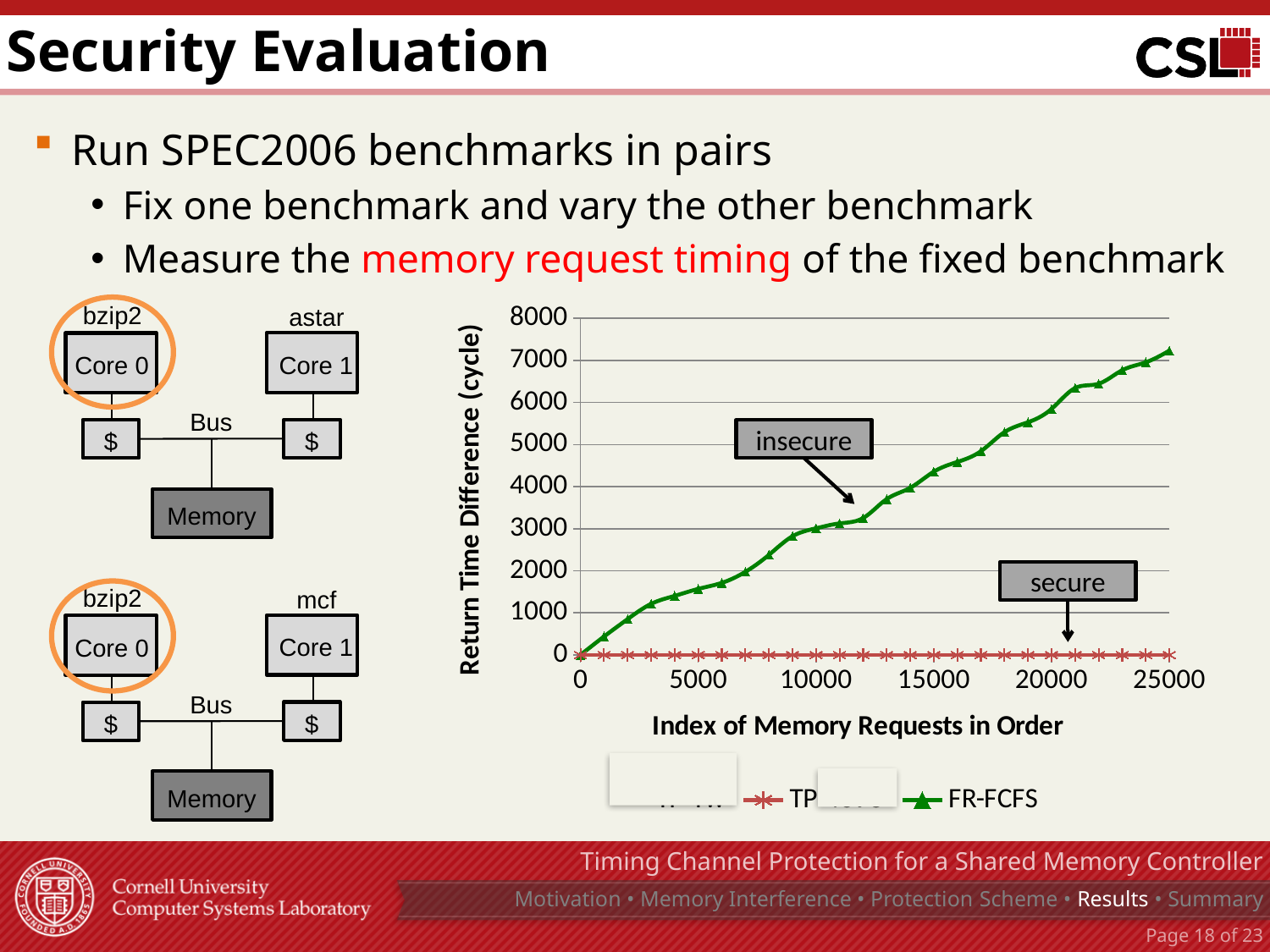
What is the title of the chart's y axis? Return Time Difference (cycle) Which series is the lowest across the whole plotted range? TP Does the FR-FCFS series rise or fall as the index of memory requests increases? rise Is the FR-FCFS value at index 5000 greater or less than 2000? less What kind of chart is shown on the slide? line chart Is the FR-FCFS value at index 5000 greater or less than 1000? greater Which series has the higher return time difference at index 20000, TP or FR-FCFS? FR-FCFS What is the title of the chart's x axis? Index of Memory Requests in Order Is the FR-FCFS value at index 20000 greater or less than 5000? greater What is the return time difference for the TP series across the plotted range? 0